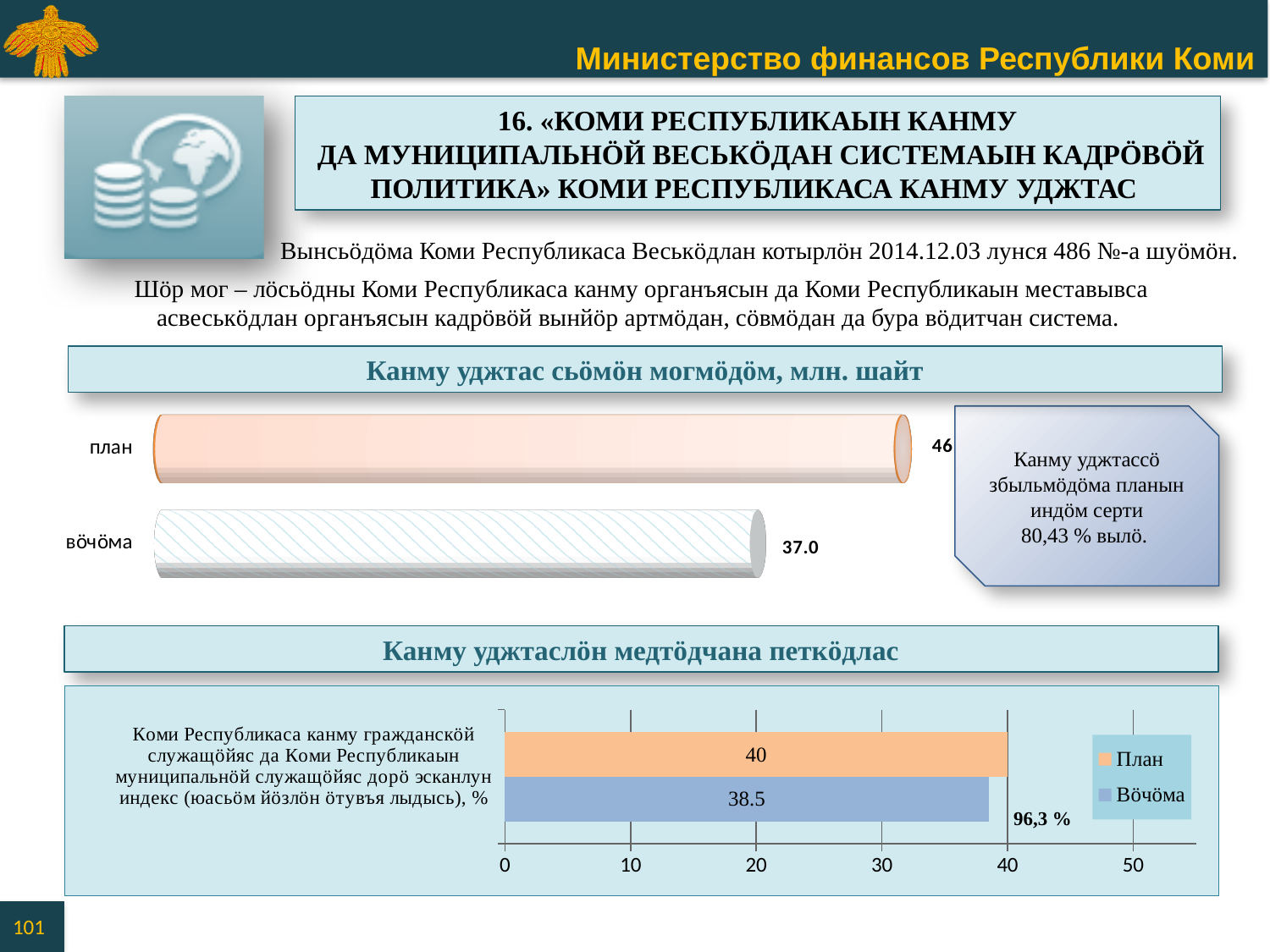
In the chart titled "Канму уджтаслӧн медтӧдчана петкӧдлас", what is the difference between the План and Вӧчӧма values? 1.5 What kind of chart is the one titled "Канму уджтас сьӧмӧн могмӧдӧм, млн. шайт"? bar chart In the chart titled "Канму уджтаслӧн медтӧдчана петкӧдлас", what is the value for Вӧчӧма? 38.5 In the chart titled "Канму уджтаслӧн медтӧдчана петкӧдлас", what is the highest value shown on the x axis? 50 In the chart titled "Канму уджтас сьӧмӧн могмӧдӧм, млн. шайт", how many bars are plotted? 2 What kind of chart is the one titled "Канму уджтаслӧн медтӧдчана петкӧдлас"? bar chart In the chart titled "Канму уджтас сьӧмӧн могмӧдӧм, млн. шайт", what is the value for вӧчӧма? 37.0 In the chart titled "Канму уджтас сьӧмӧн могмӧдӧм, млн. шайт", which bar is longer, план or вӧчӧма? план In the chart titled "Канму уджтаслӧн медтӧдчана петкӧдлас", which series has the larger value, План or Вӧчӧма? План How many series does the legend list in the chart titled "Канму уджтаслӧн медтӧдчана петкӧдлас"? 2 In the chart titled "Канму уджтаслӧн медтӧдчана петкӧдлас", what is the value for План? 40 In the chart titled "Канму уджтаслӧн медтӧдчана петкӧдлас", is the value for Вӧчӧма greater or less than 30? greater